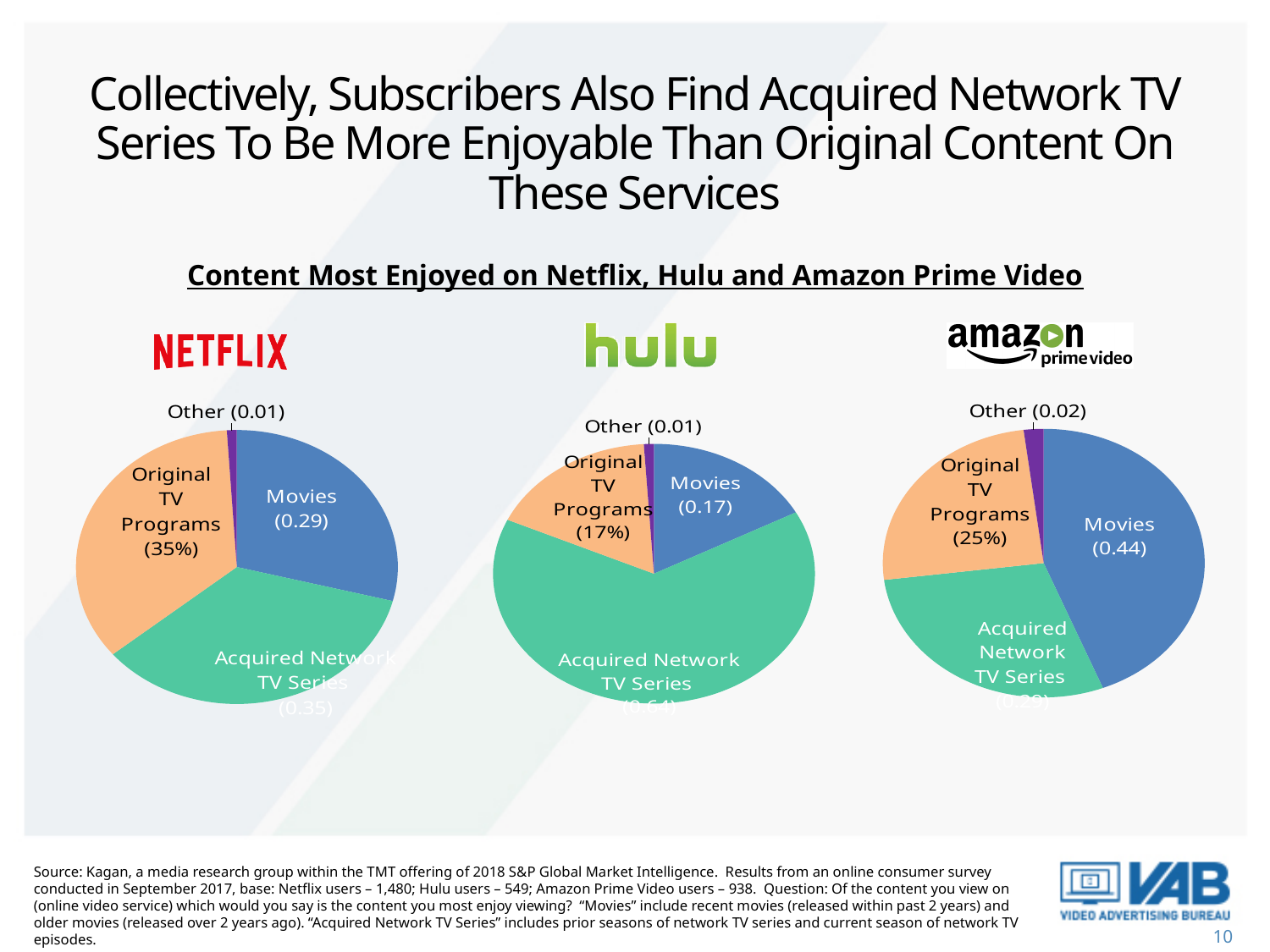
In the Netflix pie chart, what share is shown for Original TV Programs? 35% In the Netflix pie chart, what is the difference between the Movies value and the Other value? 0.28 In the Amazon Prime Video pie chart, what value is shown for Movies? 0.44 In the Netflix pie chart, which category has the smallest slice? Other In the Netflix pie chart, what value is shown for Movies? 0.29 What type of chart is used for each of the three services on the slide? Pie chart In the Amazon Prime Video pie chart, which is larger: Movies or Original TV Programs? Movies In the Hulu pie chart, which category has the largest slice? Acquired Network TV Series In the Hulu pie chart, what value is shown for Movies? 0.17 In the Amazon Prime Video pie chart, which category has the largest slice? Movies In the Hulu pie chart, what share is shown for Original TV Programs? 17% In the Amazon Prime Video pie chart, what value is shown for Other? 0.02